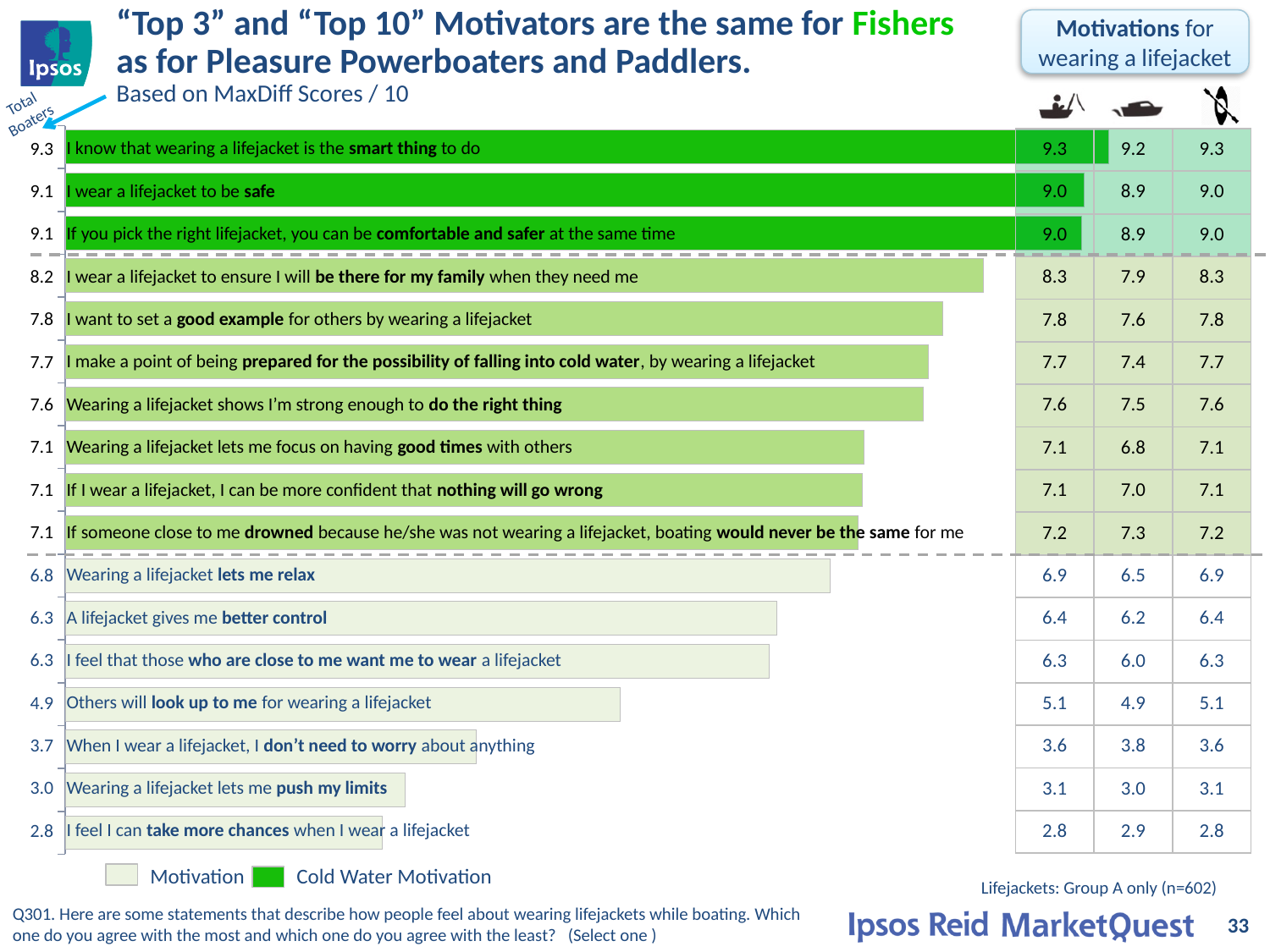
What is the Total Boaters score for "I want to set a good example for others by wearing a lifejacket"? 7.8 What type of chart is shown on the slide? Bar chart How many entries does the chart legend list? 2 What is the difference between the highest Total Boaters score (9.3) and the lowest (2.8)? 6.5 How many statements are plotted as bars in the chart? 17 How much higher is the Total Boaters score for "be there for my family" than for "set a good example"? 0.4 Which statement has the highest Total Boaters score? I know that wearing a lifejacket is the smart thing to do What is the Total Boaters score for the statement "I wear a lifejacket to be safe"? 9.1 Which statement has the lowest Total Boaters score? I feel I can take more chances when I wear a lifejacket What are the two legend entries shown below the chart? Motivation; Cold Water Motivation Which has a higher Total Boaters score: "Others will look up to me for wearing a lifejacket" or "When I wear a lifejacket, I don't need to worry about anything"? Others will look up to me for wearing a lifejacket What is the Total Boaters score for "Wearing a lifejacket lets me relax"? 6.8